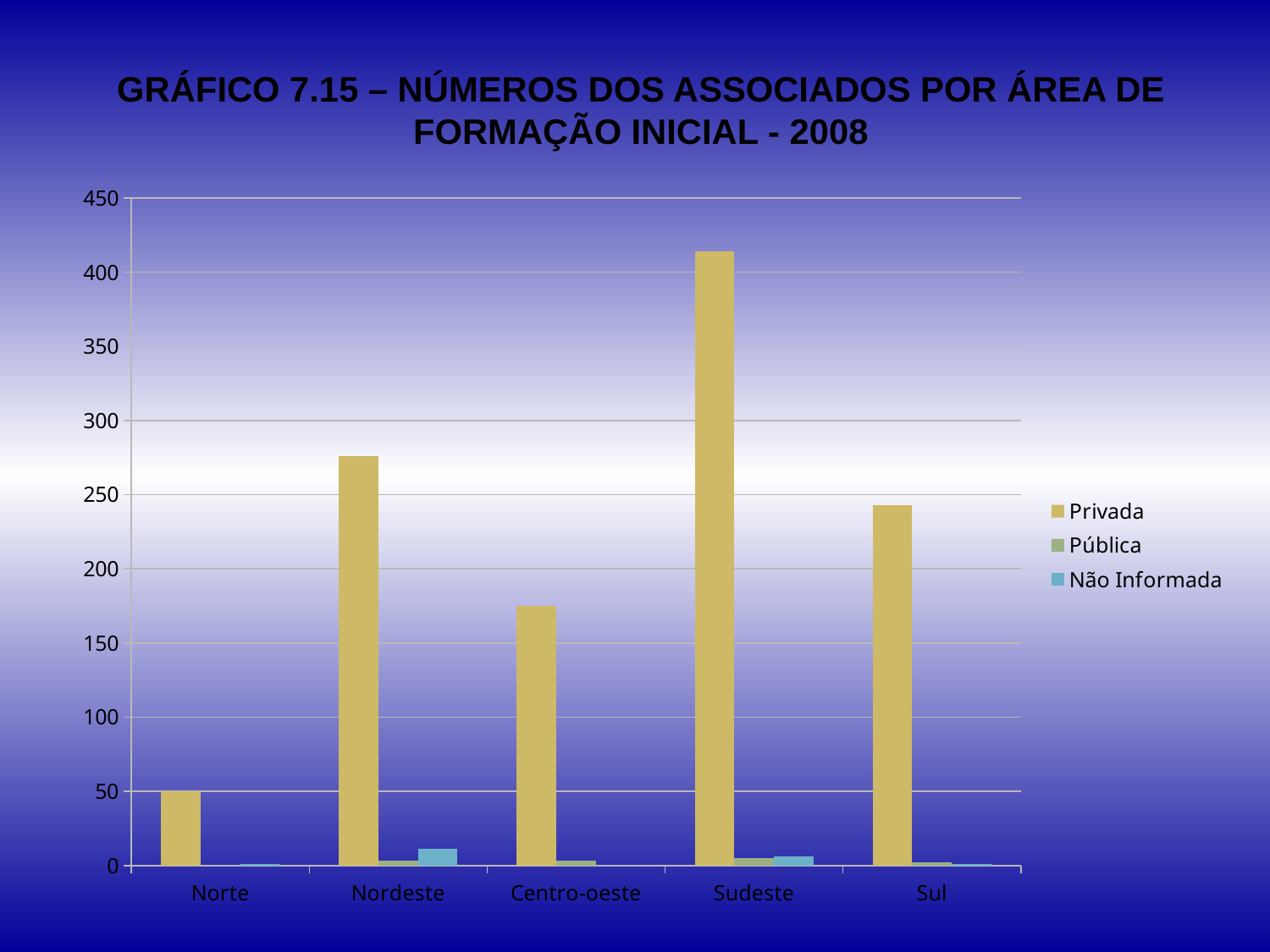
How many regions (categories) are shown on the x axis? 5 Which has the larger Privada value, Nordeste or Sul? Nordeste What kind of chart is shown on the slide? bar chart What are the three series listed in the legend? Privada, Pública, Não Informada Which region has the lowest Privada value? Norte Is the Privada value for Nordeste greater or less than 250? greater Is the Privada value for Sudeste greater or less than 400? greater Is the Privada value for Centro-oeste greater or less than 200? less How many series does the legend list? 3 Which region has the highest Não Informada value? Nordeste Which region has the highest Privada value? Sudeste